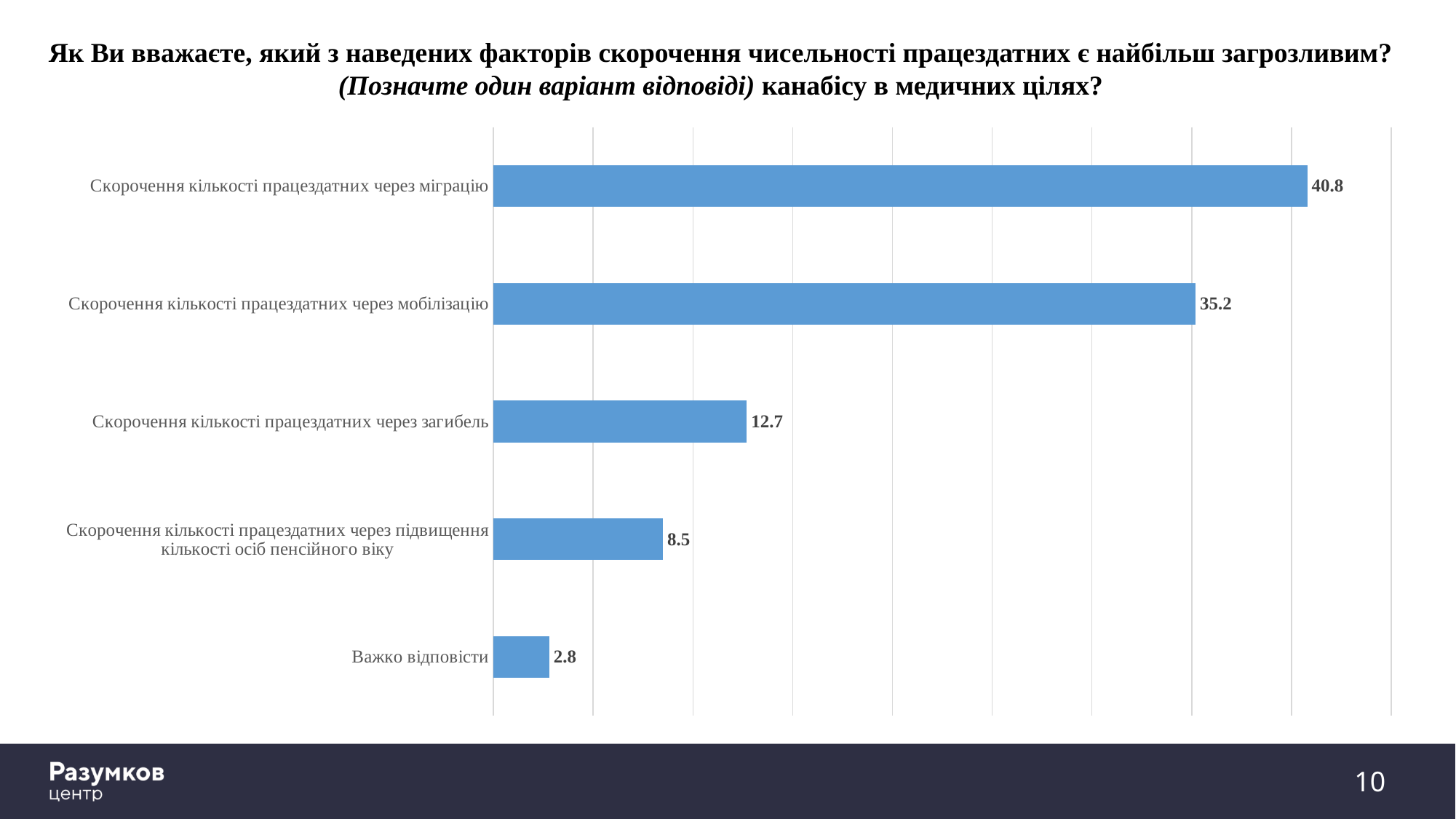
What is the value for "Скорочення кількості працездатних через підвищення кількості осіб пенсійного віку"? 8.5 What is the value for "Скорочення кількості працездатних через загибель"? 12.7 What is the value for "Скорочення кількості працездатних через мобілізацію"? 35.2 Which category has the lowest value? Важко відповісти What kind of chart is shown on the slide? Bar chart What is the value for "Скорочення кількості працездатних через міграцію"? 40.8 Which is larger: the value for "Скорочення кількості працездатних через загибель" or the value for "Скорочення кількості працездатних через підвищення кількості осіб пенсійного віку"? Скорочення кількості працездатних через загибель How many categories are shown in the chart? 5 What is the difference between the values for "Скорочення кількості працездатних через міграцію" and "Скорочення кількості працездатних через мобілізацію"? 5.6 What is the value for "Важко відповісти"? 2.8 Which category has the highest value? Скорочення кількості працездатних через міграцію What colour are the bars in the chart? Blue